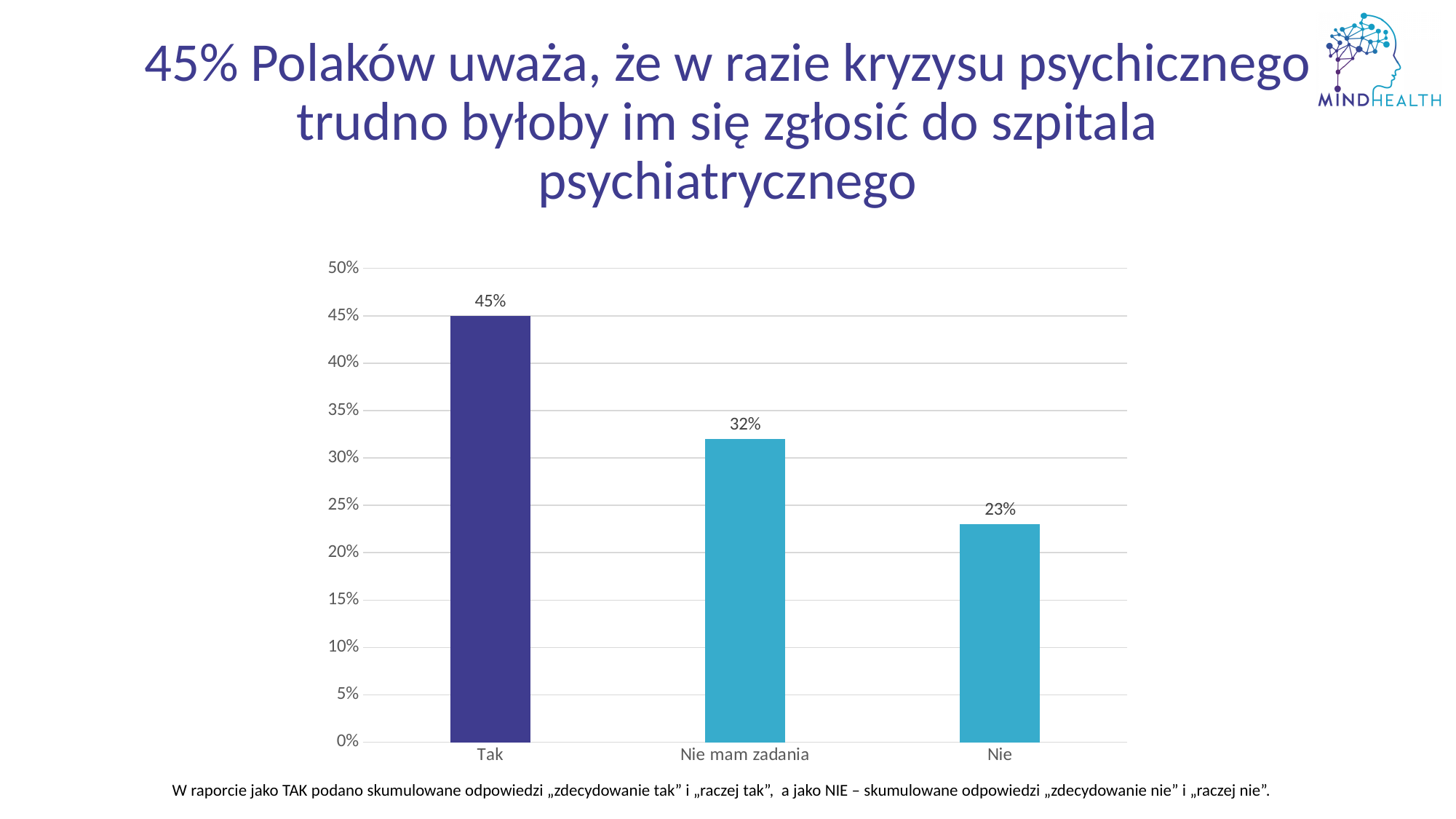
Is the value for "Nie" greater or less than 25%? less What is the difference between the values for "Nie mam zdania" and "Nie"? 9% How many categories are shown on the x axis? 3 Which category has the highest value? Tak Which is larger, the value for "Nie mam zdania" or the value for "Nie"? Nie mam zdania What is the value for "Nie"? 23% What is the value for "Nie mam zdania"? 32% Do the values rise or fall from left to right along the x axis? fall What is the difference between the values for "Tak" and "Nie"? 22% Which category has the lowest value? Nie What kind of chart is shown on the slide? bar chart What is the value for "Tak"? 45%